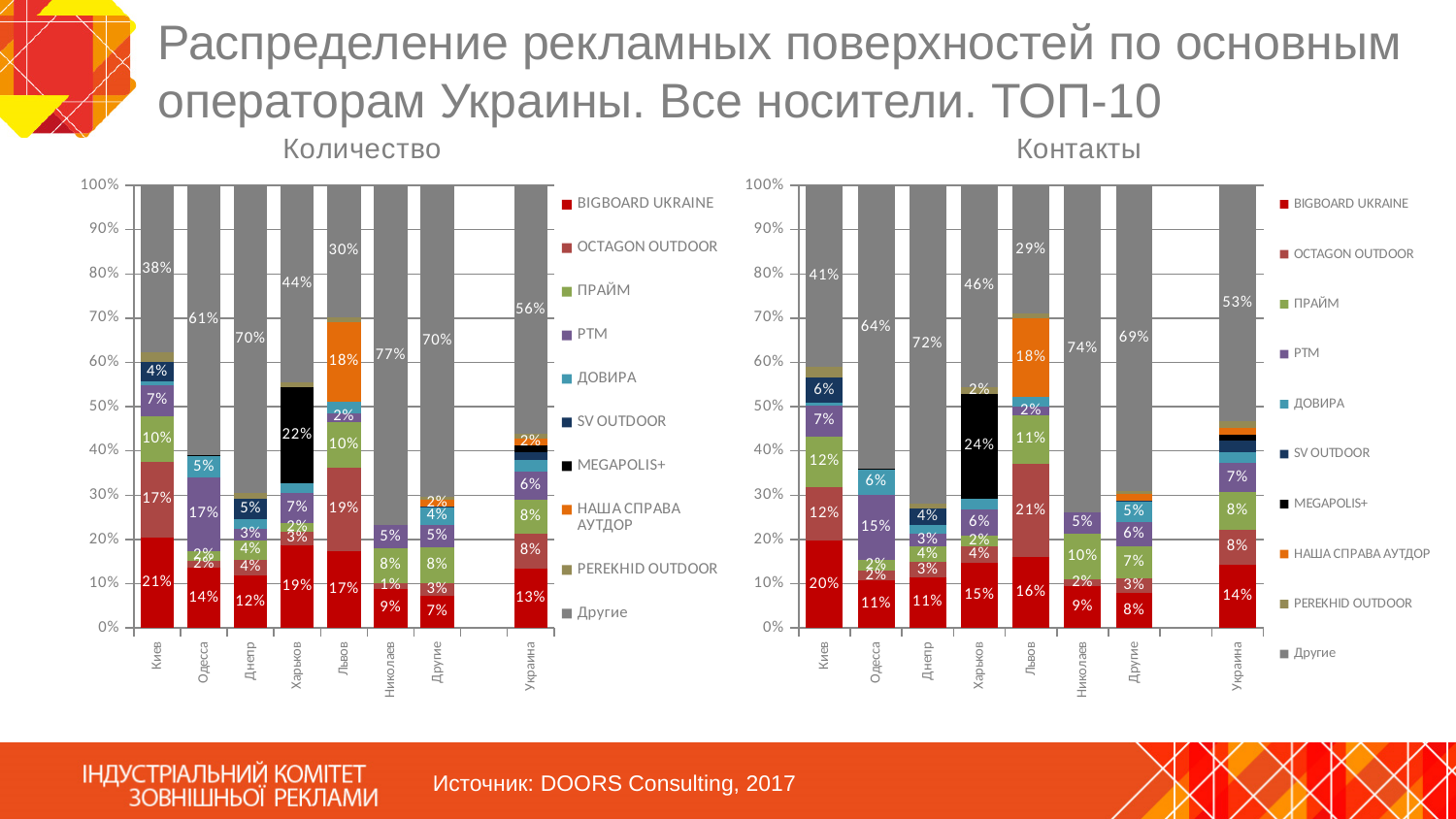
In the "Контакты" chart, which category has the lowest "Другие" share? Львов In the "Контакты" chart, which is larger for Львов: the OCTAGON OUTDOOR share or the BIGBOARD UKRAINE share? OCTAGON OUTDOOR How many series does the legend of the "Контакты" chart list? 10 In the "Количество" chart, what is the "Другие" share for Николаев? 77% In the "Количество" chart, what is the BIGBOARD UKRAINE share for Киев? 21% How many categories are shown on the x axis of the "Количество" chart? 8 In the "Контакты" chart, what is the "Другие" share for Львов? 29% In the "Контакты" chart, what is the BIGBOARD UKRAINE share for Украина? 14% In the "Количество" chart, which category has the highest "Другие" share? Николаев In the "Количество" chart, what is the difference between the "Другие" share for Одесса and for Киев? 23% In the "Контакты" chart, what is the MEGAPOLIS+ share for Харьков? 24% What type of chart is the "Количество" chart on the left? Stacked bar chart